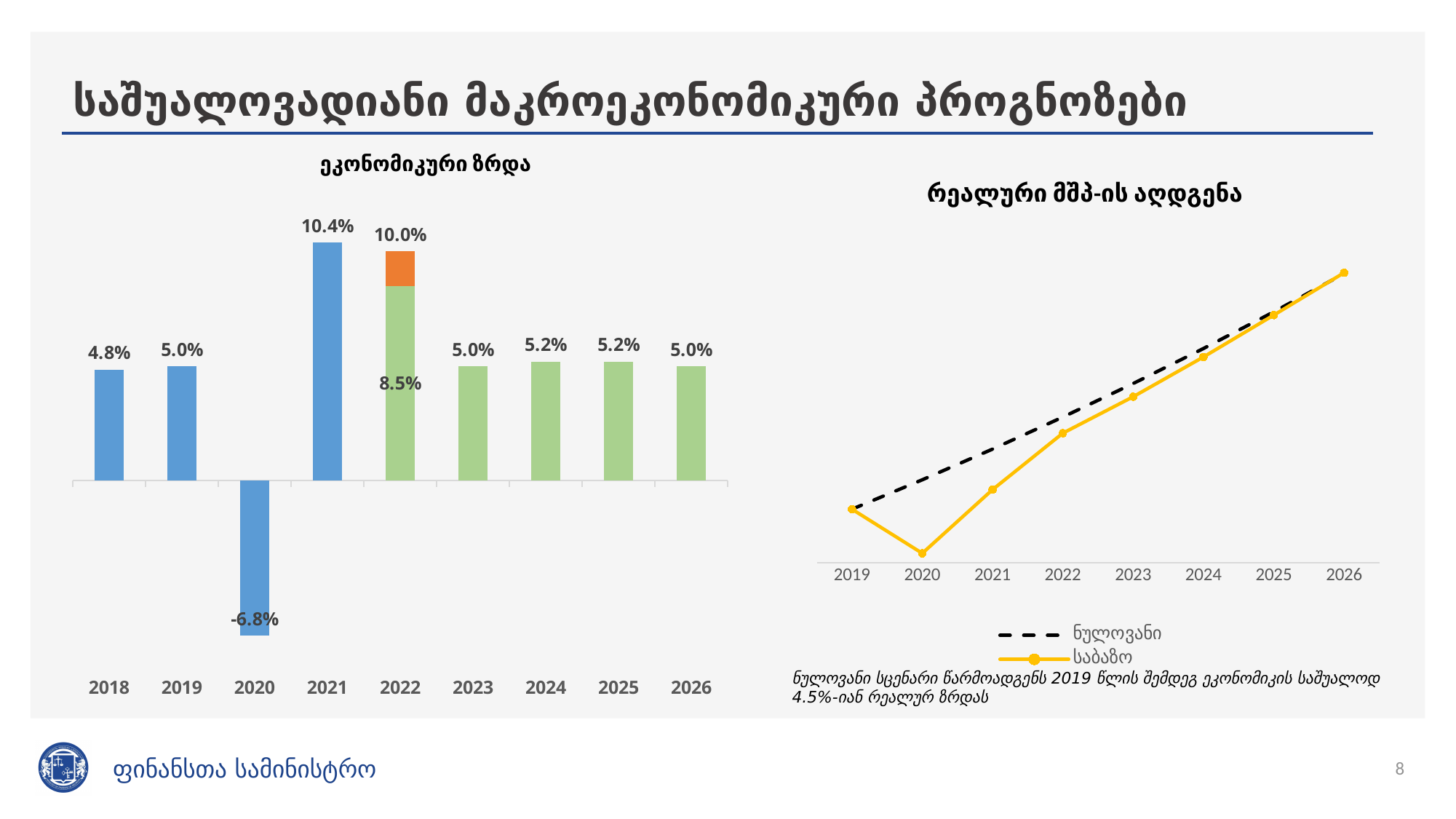
In the left chart (ეკონომიკური ზრდა), which year has the highest value? 2021 In the left chart (ეკონომიკური ზრდა), what is the value for 2020? -6.8% In the left chart (ეკონომიკური ზრდა), what is the value of the green segment of the 2022 bar? 8.5% In the left chart (ეკონომიკური ზრდა), what is the difference between the values for 2021 and 2022? 0.4% In the right chart (რეალური მშპ-ის აღდგენა), does the საბაზო series rise or fall from 2020 to 2026? rise How many series does the legend of the right chart (რეალური მშპ-ის აღდგენა) list? 2 In the left chart (ეკონომიკური ზრდა), what is the value for 2021? 10.4% What kind of chart is the right chart (რეალური მშპ-ის აღდგენა)? line chart In the left chart (ეკონომიკური ზრდა), what is the value for 2018? 4.8% In the left chart (ეკონომიკური ზრდა), which is larger, the value for 2024 or the value for 2026? 2024 In the left chart (ეკონომიკური ზრდა), how many years are shown on the x axis? 9 In the left chart (ეკონომიკური ზრდა), which year has the lowest value? 2020